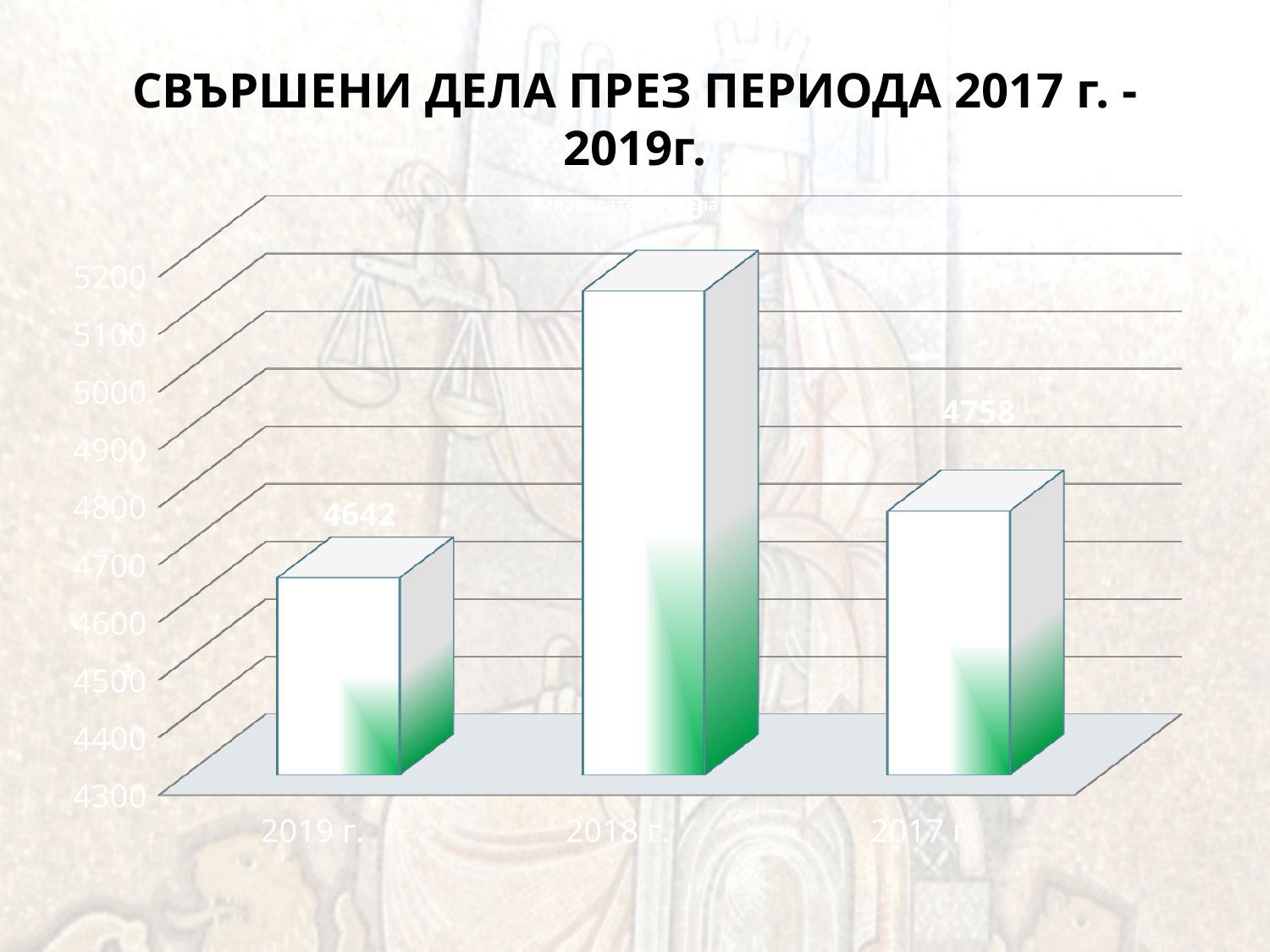
What is the value for 2017 г.? 4758 How many bars are shown in the chart? 3 Is the value for 2019 г. greater or less than 4700? less Is the value for 2018 г. greater or less than 5000? greater Which year has the highest bar? 2018 г. What kind of chart is shown on the slide? bar chart What is the difference between the values for 2017 г. and 2019 г.? 116 What is the title of the slide? СВЪРШЕНИ ДЕЛА ПРЕЗ ПЕРИОДА 2017 г. - 2019г. Do the values rise or fall from 2019 г. to 2018 г. along the x axis? rise Which year has the lowest bar? 2019 г. Which is larger, the value for 2017 г. or the value for 2019 г.? 2017 г. What is the value for 2019 г.? 4642